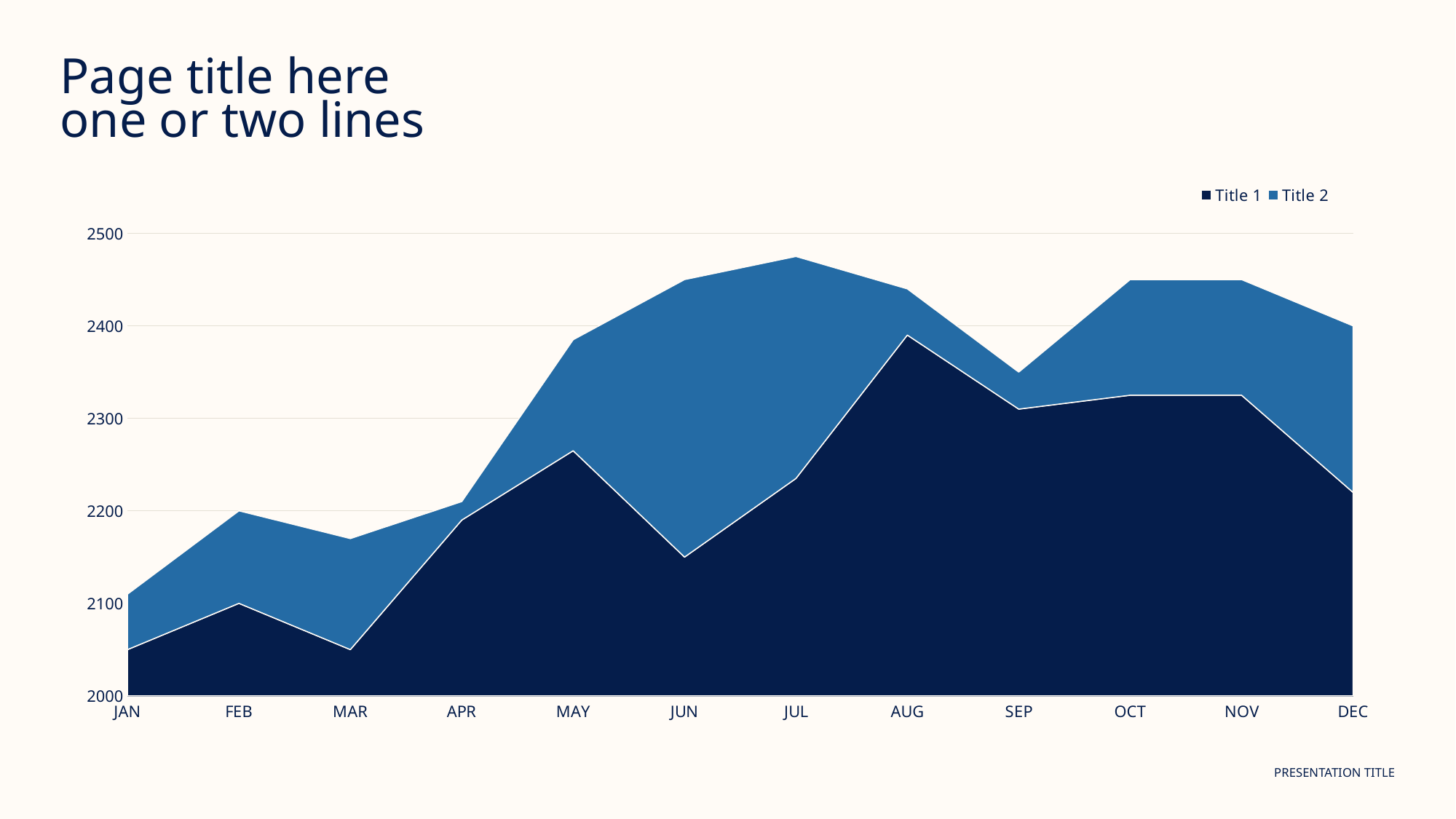
What kind of chart is shown on the slide? Area chart In which month does the Title 1 series reach its highest value? AUG How many series does the legend list? 2 Is the value of Title 1 in JUN greater or less than 2200? less Does the Title 1 series rise or fall from MAY to JUN? Fall In which month does the top edge of the Title 2 area reach its highest point? JUL Is the value of Title 1 in MAY greater or less than 2200? greater Does the Title 1 series rise or fall from JUN to AUG? Rise How many months are shown along the x axis? 12 What are the two series names shown in the legend? Title 1 and Title 2 Which is larger for Title 1: the value in AUG or the value in JUN? AUG Is the value of Title 1 in AUG greater or less than 2300? greater